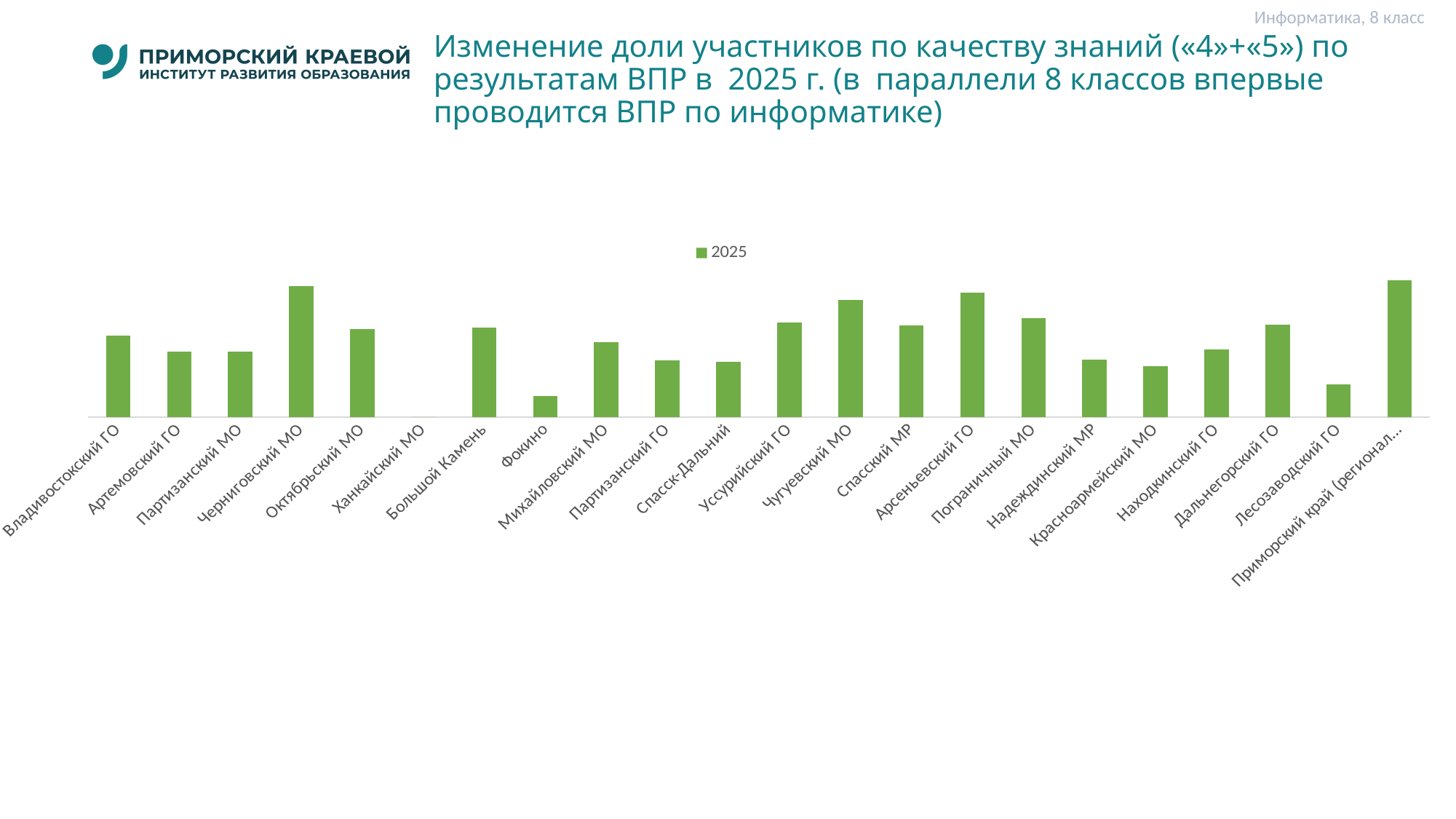
What kind of chart is shown on the slide? bar chart Which is larger, the value for Арсеньевский ГО or the value for Надеждинский МР? Арсеньевский ГО Which is larger, the value for Уссурийский ГО or the value for Спасск-Дальний? Уссурийский ГО How many categories are shown along the x axis of the chart? 22 How many series does the legend list? 1 What is the legend entry for the series shown in the chart? 2025 Which category shows no bar at all (the lowest value) in the chart? Ханкайский МО What colour are the bars in the chart? green Which is larger, the value for Чугуевский МО or the value for Михайловский МО? Чугуевский МО